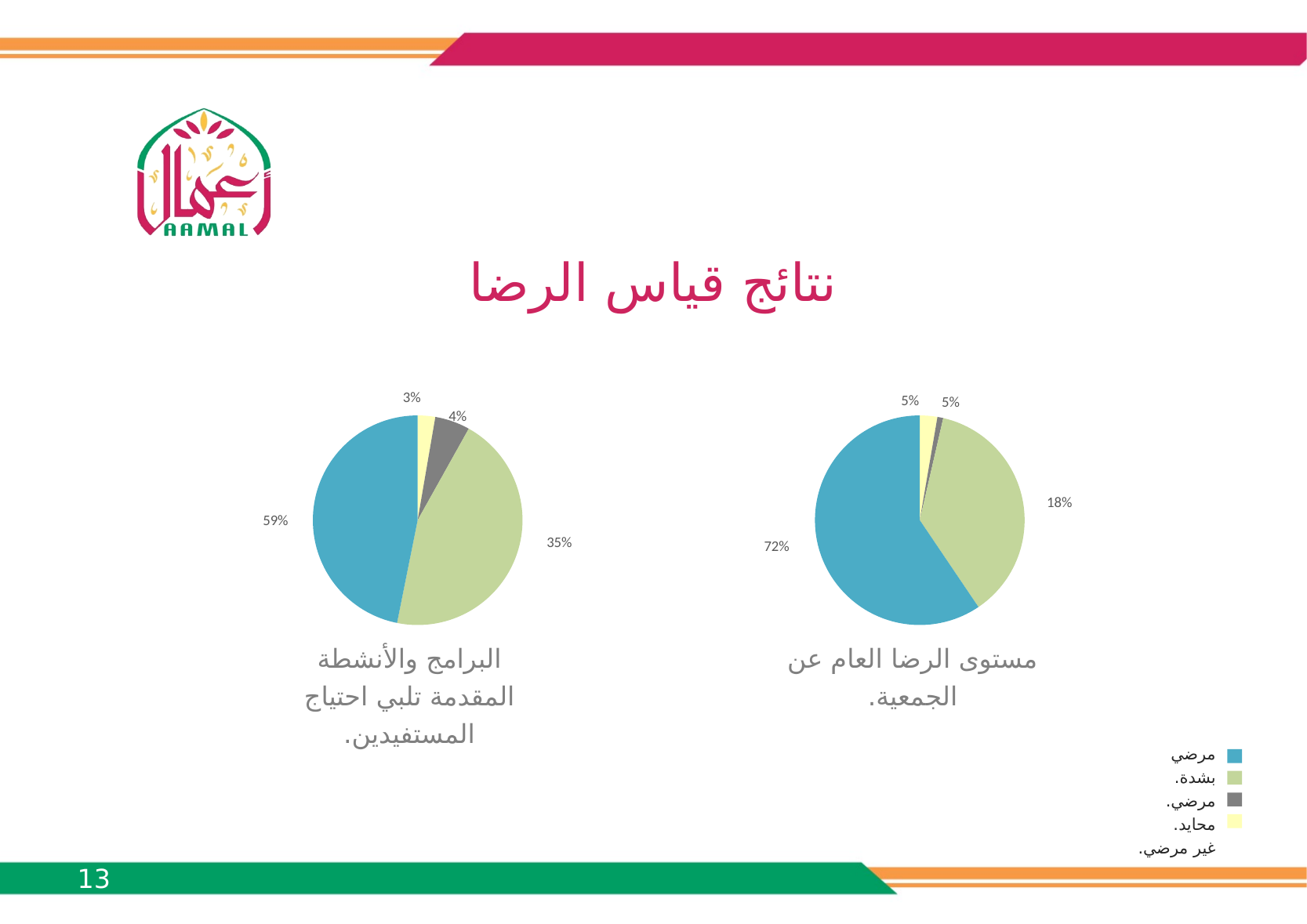
What kind of chart is used on this slide? Pie chart How many slices does the right chart (مستوى الرضا العام عن الجمعية) have? 4 In the left chart (البرامج والأنشطة المقدمة تلبي احتياج المستفيدين), what is the difference between the blue slice (59%) and the light green slice (35%)? 24 percentage points In the left chart (البرامج والأنشطة المقدمة تلبي احتياج المستفيدين), what is the value of the largest slice? 59% In the left chart (البرامج والأنشطة المقدمة تلبي احتياج المستفيدين), what is the value of the smallest slice? 3% What is the title of the slide above the charts? نتائج قياس الرضا In the right chart (مستوى الرضا العام عن الجمعية), what is the value of the largest slice? 72% How many slices does the left chart (البرامج والأنشطة المقدمة تلبي احتياج المستفيدين) have? 4 In the left chart (البرامج والأنشطة المقدمة تلبي احتياج المستفيدين), what is the value of the light green slice? 35% In the right chart (مستوى الرضا العام عن الجمعية), what is the value of the light green slice? 18% In the right chart (مستوى الرضا العام عن الجمعية), what is the difference between the blue slice (72%) and the light green slice (18%)? 54 percentage points How many pie charts are shown on the slide? 2